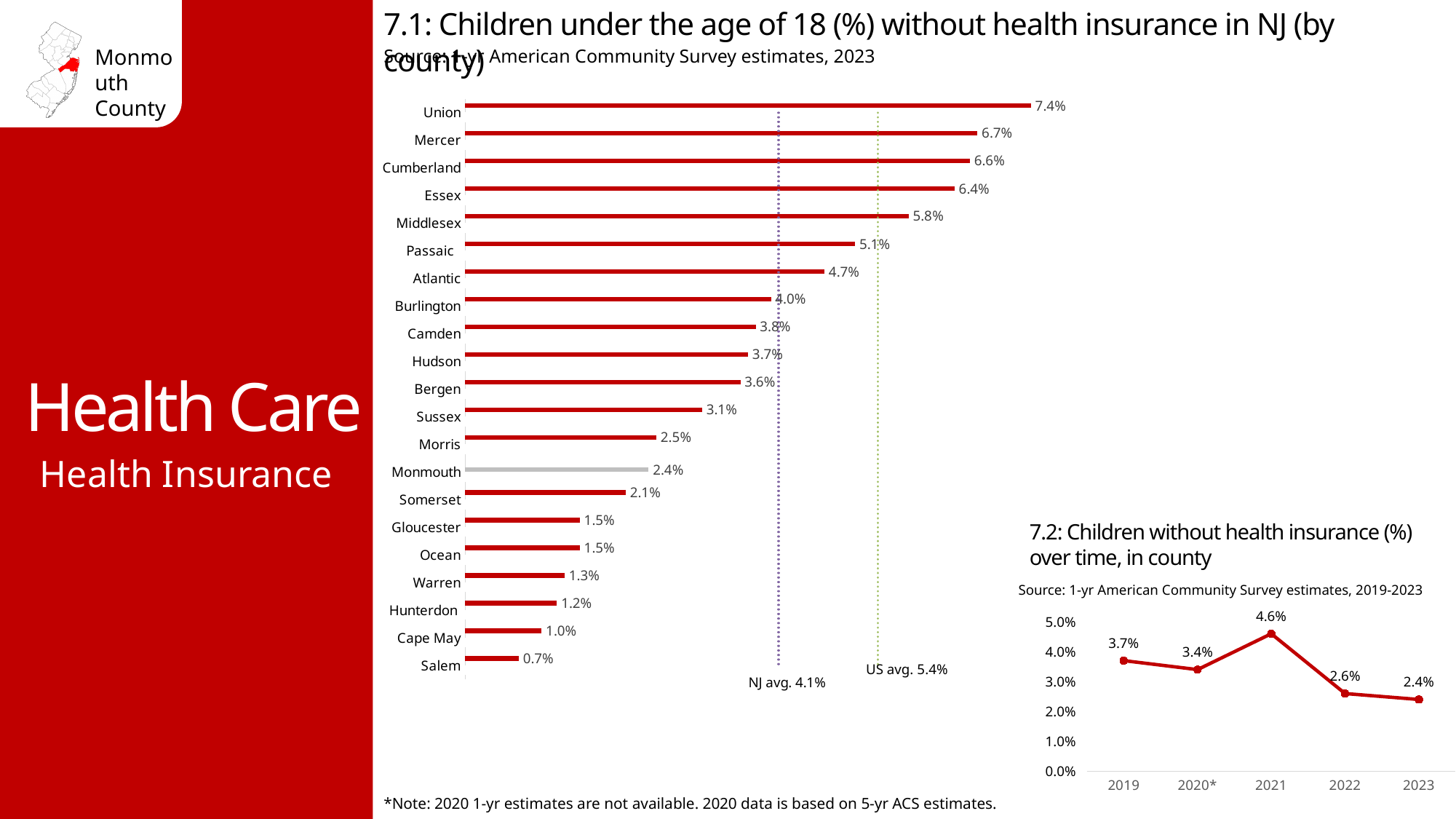
In chart 7.2, how many years are plotted? 5 In chart 7.1, what is the value for Hudson? 3.7% In chart 7.1, which county has a larger value, Essex or Passaic? Essex In chart 7.1, what is the difference between the values for Union and Salem? 6.7% In chart 7.1, what NJ average is marked by the dotted line? 4.1% In chart 7.1, how many counties are shown? 21 In chart 7.1, which county has the highest percentage of children without health insurance? Union In chart 7.2, what is the difference between the values for 2021 and 2023? 2.2% In chart 7.1, which county has the lowest percentage of children without health insurance? Salem In chart 7.1 (children under 18 without health insurance by county), what is the value for Monmouth? 2.4% What kind of chart is chart 7.2 (children without health insurance over time)? Line chart In chart 7.2, what is the value for 2021? 4.6%